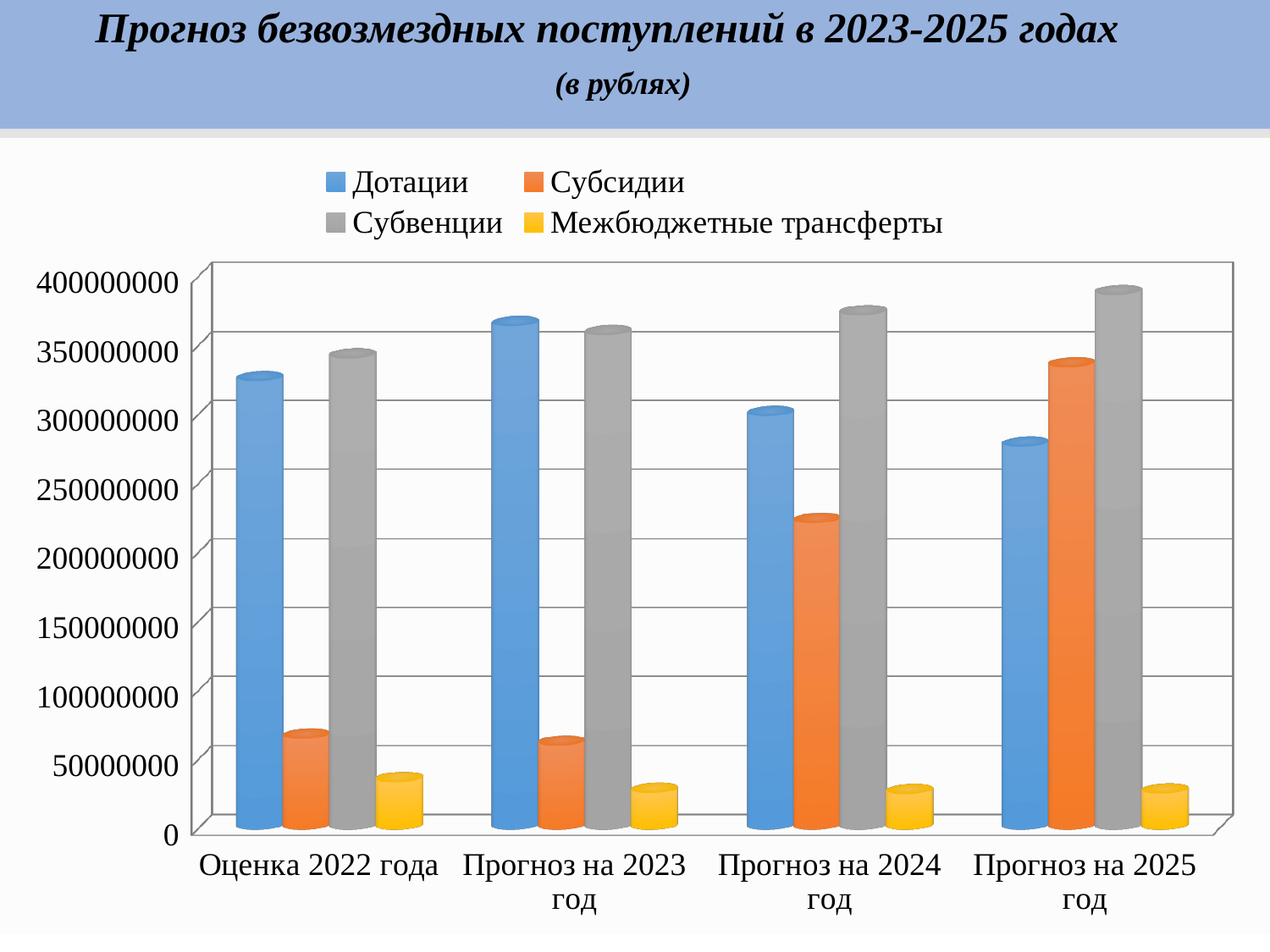
Is the value for Субвенции in Прогноз на 2025 год greater or less than 350000000? greater Which series has the highest value in Прогноз на 2025 год? Субвенции Is the value for Субсидии in Прогноз на 2023 год greater or less than 100000000? less How many categories are shown along the x axis? 4 Which colour represents Субвенции in the legend? grey How many series does the legend list? 4 In Прогноз на 2025 год, which is larger: Субсидии or Дотации? Субсидии Do the values for Субвенции rise or fall from Оценка 2022 года to Прогноз на 2025 год? rise What kind of chart is shown on the slide? bar chart Is the value for Субсидии in Прогноз на 2024 год greater or less than 200000000? greater Which series has the lowest value in Оценка 2022 года? Межбюджетные трансферты